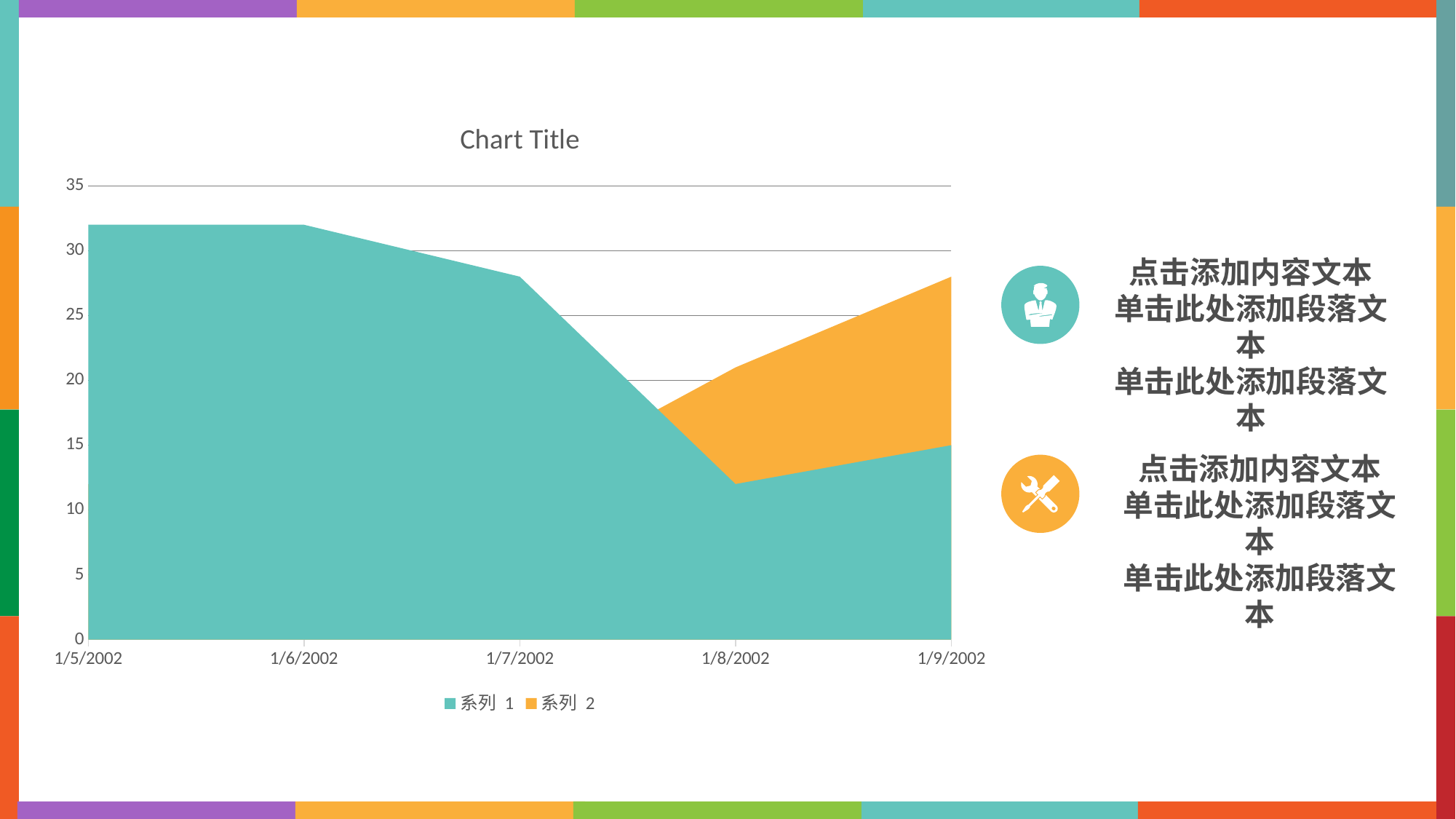
Which series is shown in orange in the chart? 系列 2 Is the value for 系列 1 at 1/7/2002 greater or less than 25? greater Does the value of 系列 1 rise or fall from 1/6/2002 to 1/8/2002? fall What kind of chart is shown on the slide? area chart Is the value for 系列 1 at 1/9/2002 greater or less than 20? less How many dates are shown on the x axis of the chart? 5 How many series does the legend list? 2 Is the value for 系列 1 at 1/5/2002 greater or less than 30? greater At which date does 系列 1 reach its lowest value? 1/8/2002 What is the title of the chart? Chart Title